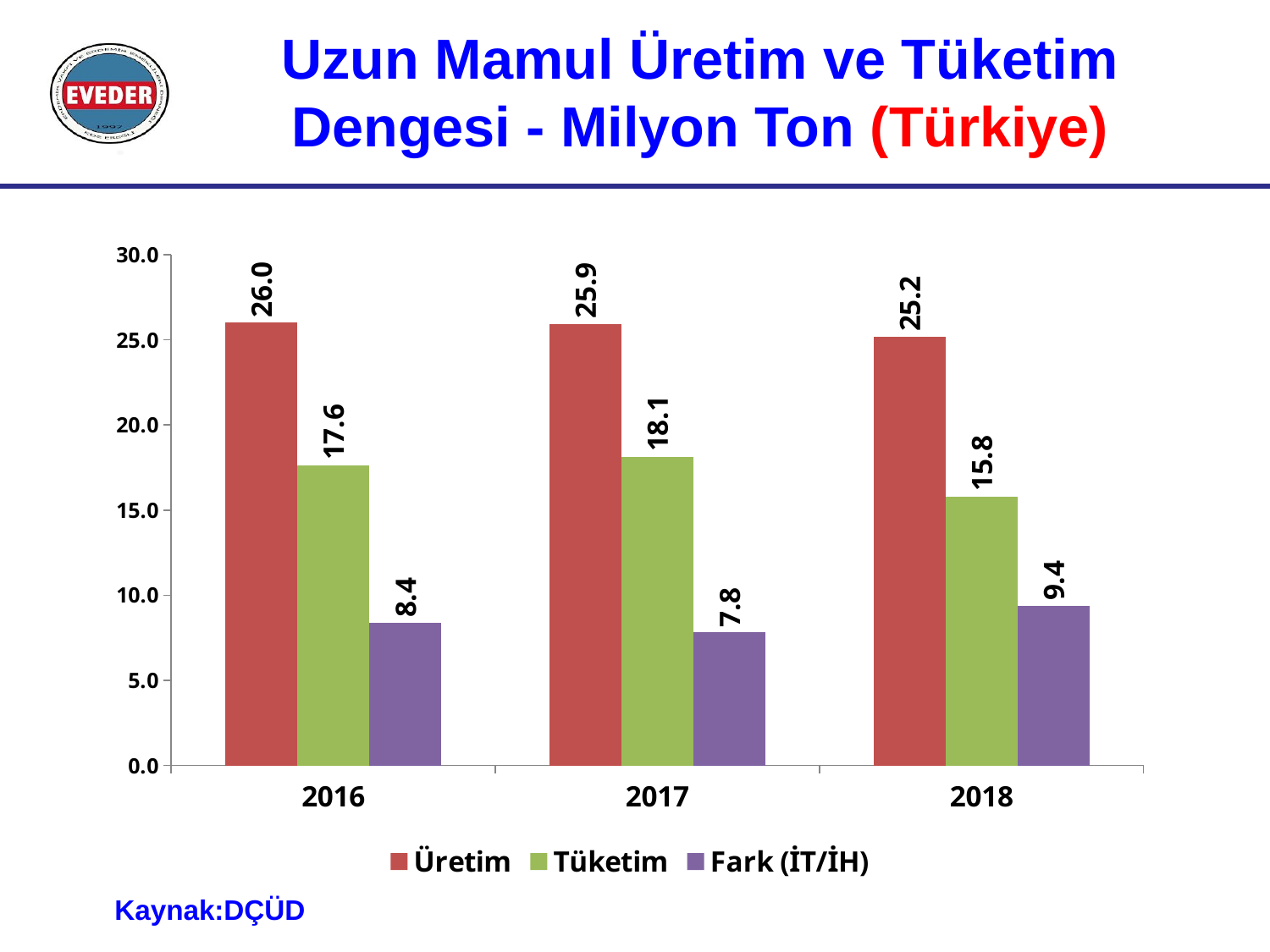
Which is larger, the Tüketim value for 2017 or the Tüketim value for 2016? 2017 How many years are shown on the x axis? 3 What kind of chart is shown on the slide? bar chart In which year is the Fark (İT/İH) value lowest? 2017 How many series does the legend list? 3 Is the Fark (İT/İH) value for 2018 greater or less than 10.0? less What is the Üretim value for 2017? 25.9 Does the Üretim value rise or fall from 2016 to 2018? fall What is the Tüketim value for 2018? 15.8 In which year is the Üretim value highest? 2016 What is the Fark (İT/İH) value for 2016? 8.4 What is the difference between Üretim and Tüketim in 2018? 9.4